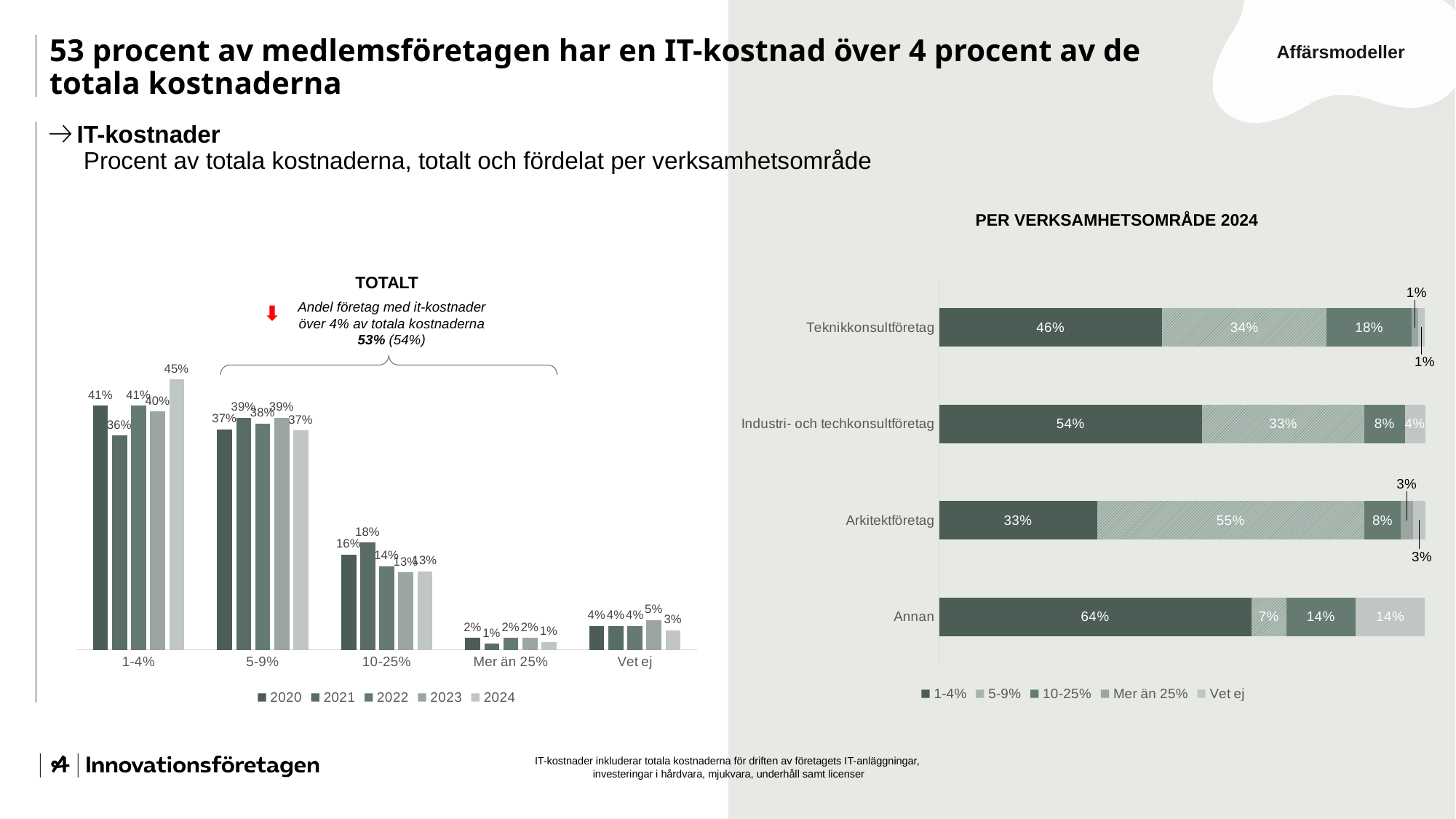
In the TOTALT chart, how many categories are shown on the x axis? 5 What kind of chart is the PER VERKSAMHETSOMRÅDE 2024 chart? Stacked bar chart In the TOTALT chart, how many series does the legend list? 5 In the TOTALT chart, what is the value for 2021 in the 10-25% category? 18% In the TOTALT chart, which year has the lowest value in the 1-4% category? 2021 In the PER VERKSAMHETSOMRÅDE 2024 chart, is the 10-25% share larger for Teknikkonsultföretag or for Arkitektföretag? Teknikkonsultföretag In the PER VERKSAMHETSOMRÅDE 2024 chart, what is the 5-9% share for Arkitektföretag? 55% In the TOTALT chart, do the 2024 values rise or fall from the 1-4% category to the 10-25% category? fall In the PER VERKSAMHETSOMRÅDE 2024 chart, which business area has the highest 1-4% share? Annan In the TOTALT chart, what is the value for 2024 in the 1-4% category? 45% In the PER VERKSAMHETSOMRÅDE 2024 chart, what is the 1-4% share for Annan? 64% In the TOTALT chart, what is the difference between the 2024 and 2020 values in the 10-25% category? 3%